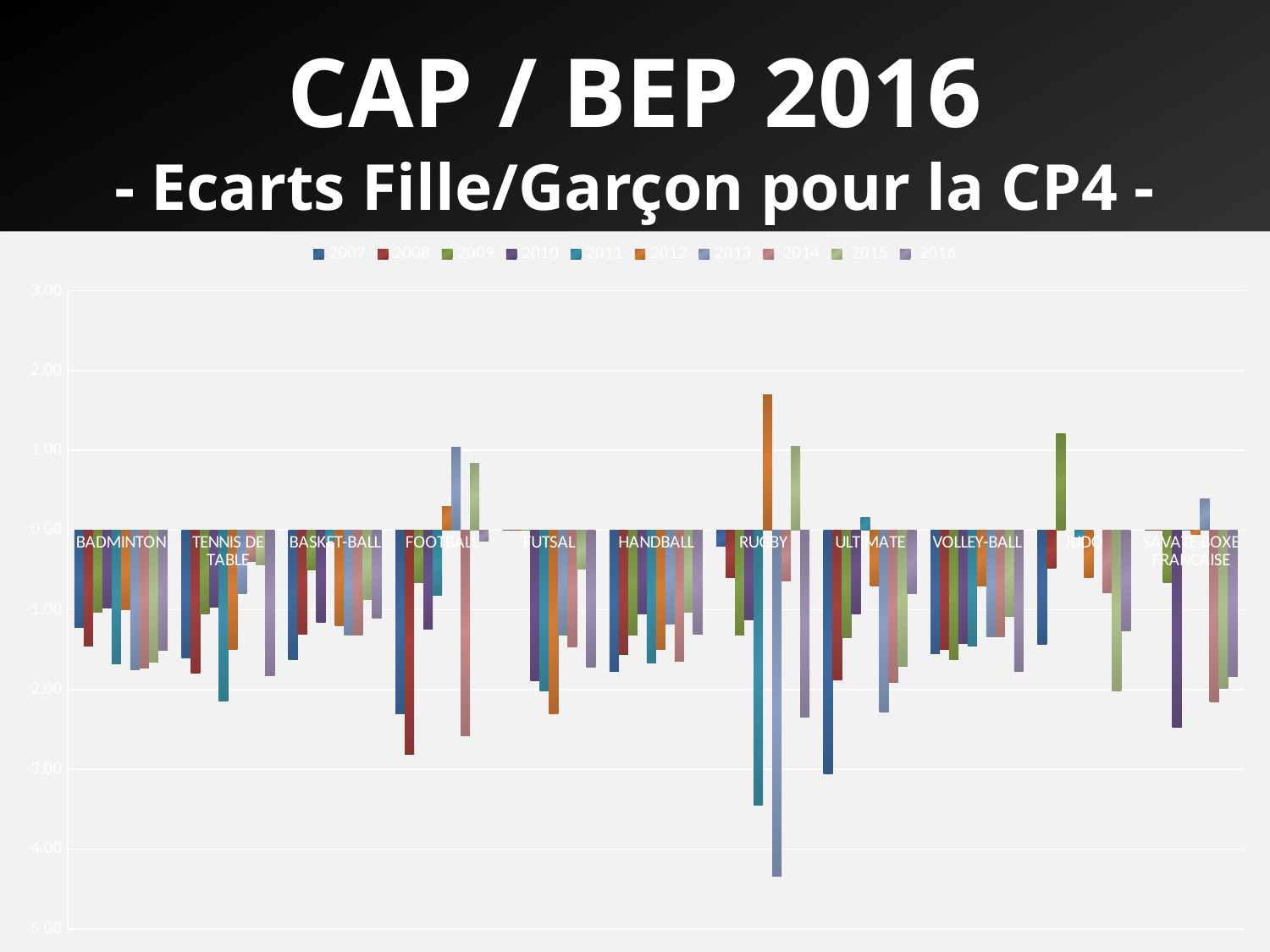
Which category contains the lowest bar on the chart? RUGBY Is the value for FOOTBALL in 2008 greater or less than -2.00? less Which category contains the highest bar on the chart? RUGBY What kind of chart is shown on the slide? bar chart Which is larger, the 2012 value for RUGBY or the 2009 value for JUDO? 2012 value for RUGBY Which years does the legend cover? 2007 to 2016 What is the subtitle of the chart slide? - Ecarts Fille/Garçon pour la CP4 - Is the value for RUGBY in 2013 greater or less than -4.00? less How many sport categories are shown on the x axis? 11 Is the value for RUGBY in 2011 greater or less than -3.00? less How many series does the legend list? 10